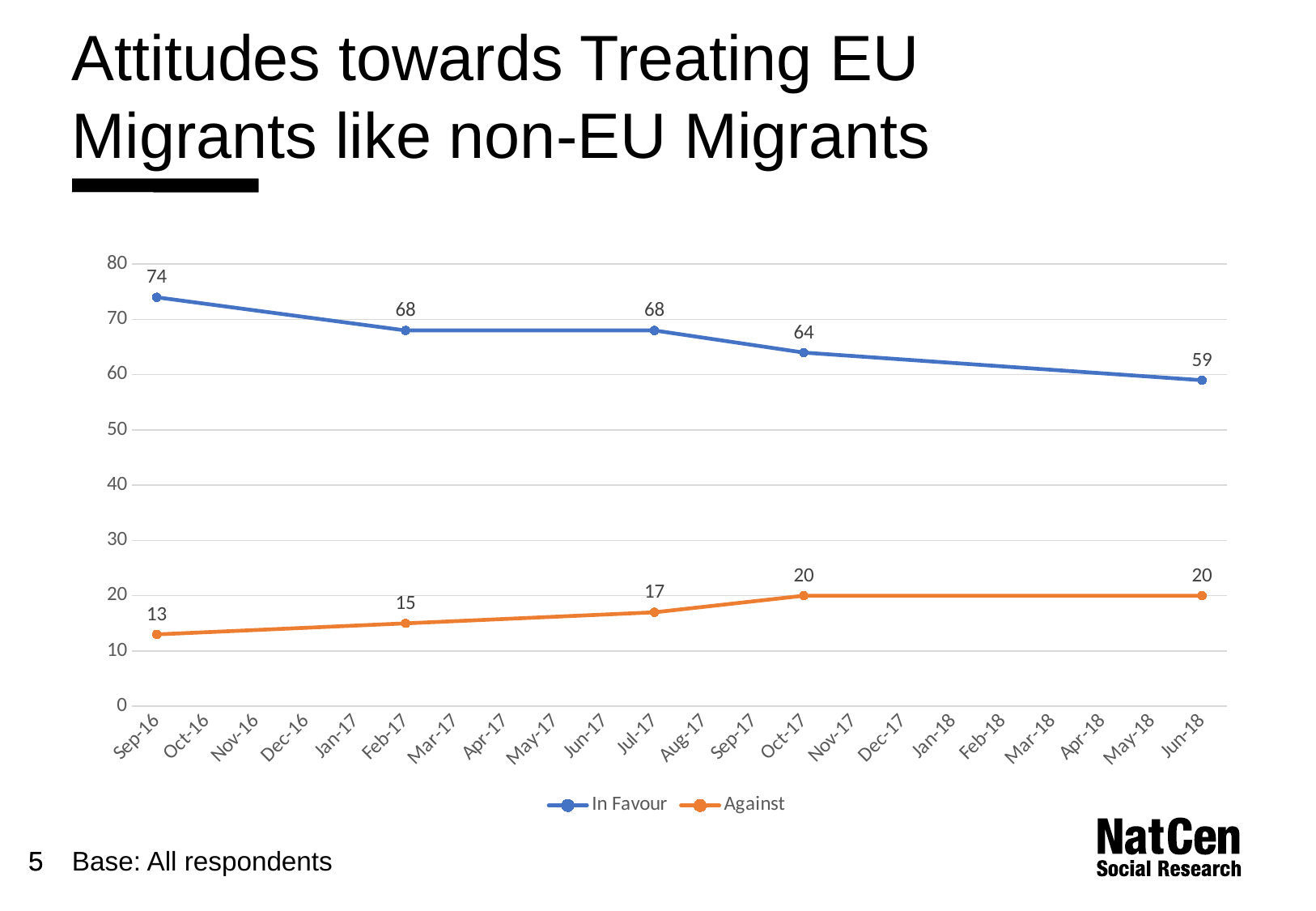
Which colour is used for the Against series? Orange What is the value for Against in Jul-17? 17 At which date is the In Favour series highest? Sep-16 How many series does the legend list? 2 What is the value for In Favour in Sep-16? 74 How many data points are plotted for the In Favour series? 5 Does the In Favour series rise or fall from Sep-16 to Jun-18? Fall What is the value for In Favour in Jun-18? 59 What is the difference between In Favour and Against in Oct-17? 44 At which date is the Against series lowest? Sep-16 Which is larger in Feb-17, In Favour or Against? In Favour What kind of chart is shown on the slide? Line chart